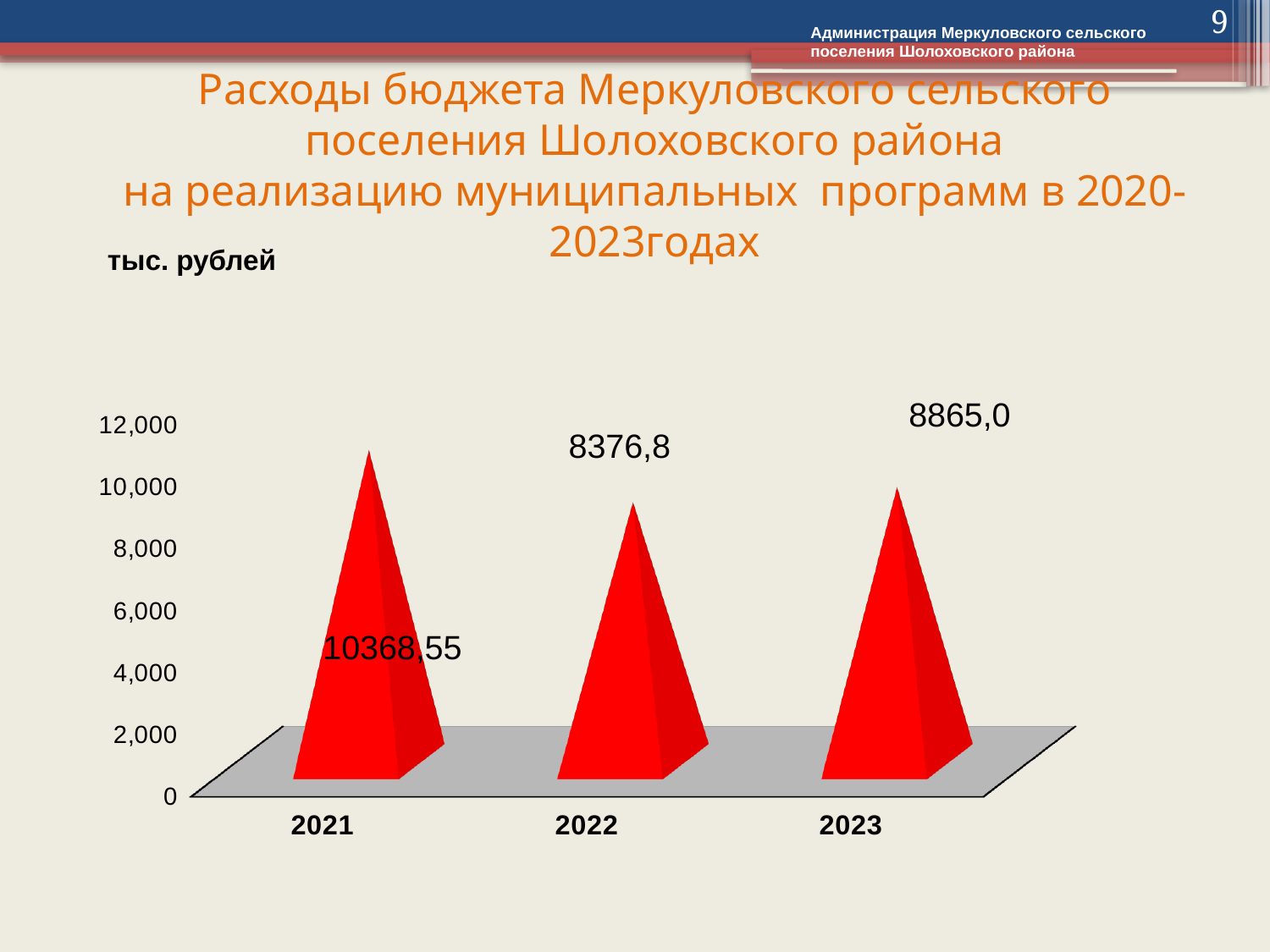
What kind of chart is shown on the slide? bar chart What is the value for 2021? 10368,55 Which year has the lowest value? 2022 How many years are shown on the chart? 3 Which year has the highest value? 2021 Is the value for 2021 greater or less than 10,000? greater What is the value for 2022? 8376,8 What is the value for 2023? 8865,0 Which is larger, the value for 2022 or the value for 2023? 2023 What is the difference between the values for 2023 and 2022? 488,2 What is the difference between the values for 2021 and 2022? 1991,75 In what units are the values on the chart given? тыс. рублей